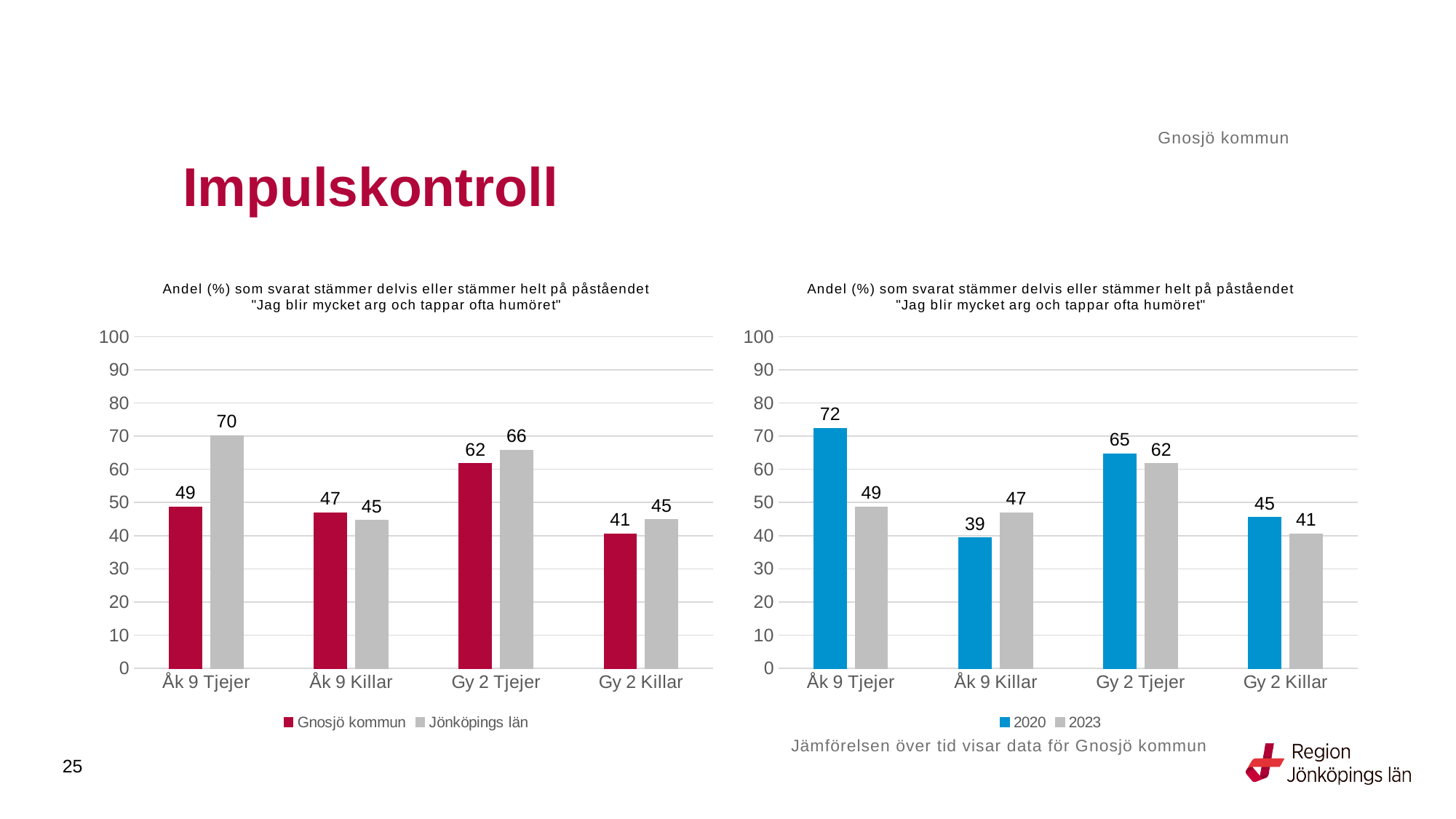
In the right chart, what is the value for 2023 for Gy 2 Killar? 41 In the left chart, which category has the highest value for Jönköpings län? Åk 9 Tjejer In the left chart, which is larger for Åk 9 Killar: Gnosjö kommun or Jönköpings län? Gnosjö kommun In the left chart, what is the value for Gnosjö kommun for Åk 9 Tjejer? 49 In the right chart, what is the difference between 2020 and 2023 for Åk 9 Tjejer? 23 What kind of chart is the left chart? Bar chart In the left chart, what is the value for Jönköpings län for Gy 2 Tjejer? 66 In the right chart, what is the value for 2020 for Åk 9 Killar? 39 How many series does the legend of the right chart list? 2 In the left chart, which category has the lowest value for Gnosjö kommun? Gy 2 Killar In the left chart, what is the difference between Jönköpings län and Gnosjö kommun for Åk 9 Tjejer? 21 In the right chart, which category has the highest value for 2020? Åk 9 Tjejer